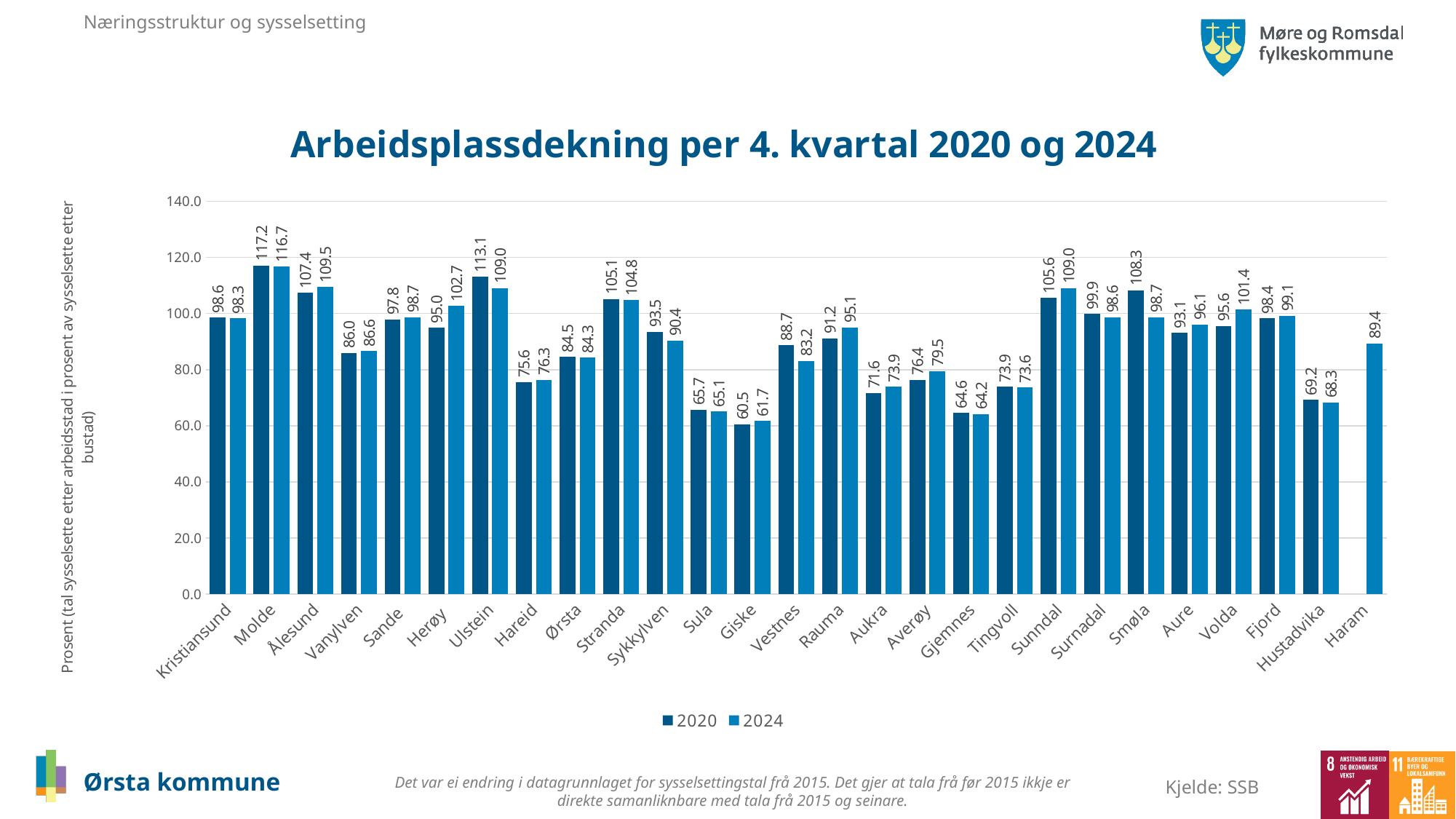
Which municipality has the highest 2020 value? Molde Which is larger for Sunndal: the 2020 value or the 2024 value? 2024 What is the 2020 value for Ulstein? 113.1 How much higher is Herøy's 2024 value than its 2020 value? 7.7 Which municipality has the lowest 2024 value? Giske What type of chart is shown? Bar chart How many series does the legend list? 2 Is the 2024 value for Volda greater or less than 100.0? greater How many municipalities are shown on the x axis? 27 By how much did Smøla's value fall from 2020 to 2024? 9.6 What is the 2024 value for Haram? 89.4 What is the 2024 value for Ørsta? 84.3